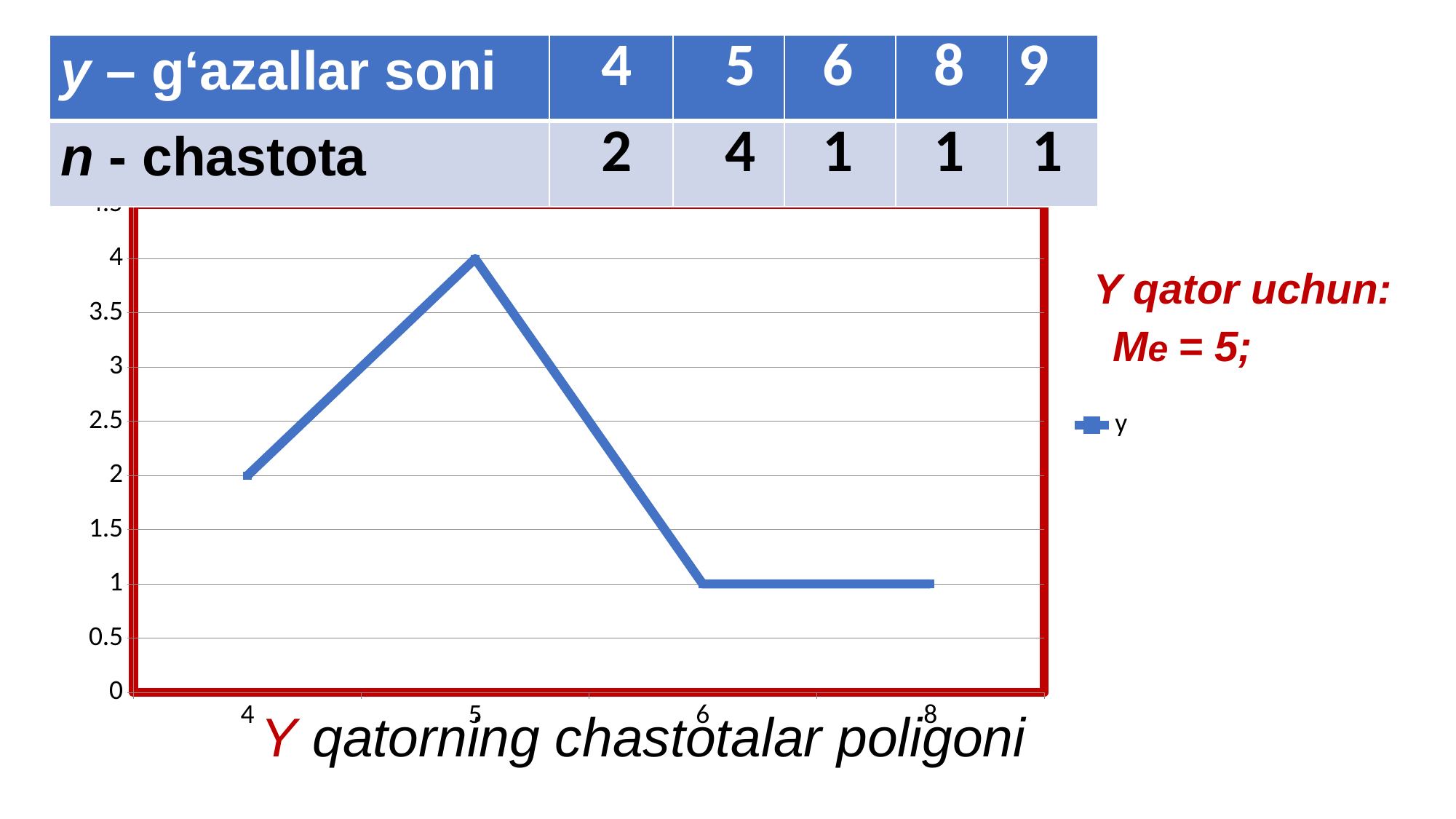
What is the value of the line at x = 4? 2 At which x-axis category does the line reach its highest value? 5 What kind of chart is shown on the slide? line chart What is the value of the line at x = 5? 4 What is the name of the series shown in the legend? y Is the value at x = 5 greater or less than 3? greater Which is larger, the value at x = 4 or the value at x = 6? x = 4 What is the difference between the value at x = 5 and the value at x = 4? 2 Does the line rise or fall between x = 5 and x = 6? fall What is the value of the line at x = 6? 1 What is the value of the line at x = 8? 1 How many series does the chart legend list? 1